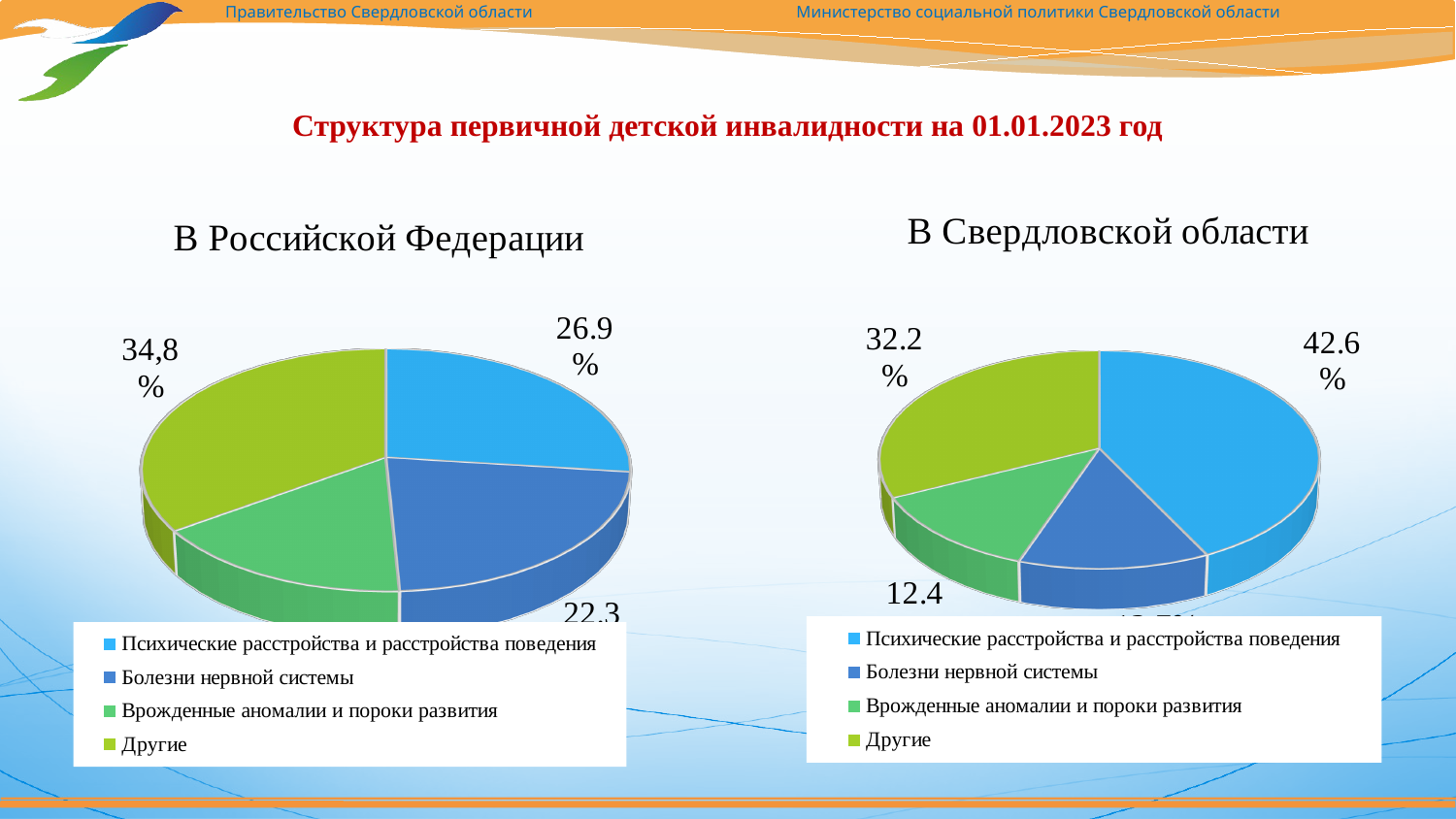
In the chart 'В Свердловской области', what share is shown for Психические расстройства и расстройства поведения? 42.6% In the chart 'В Свердловской области', which category has the largest slice? Психические расстройства и расстройства поведения What type of chart is used for 'В Российской Федерации'? Pie chart In the chart 'В Свердловской области', what value is shown for Врожденные аномалии и пороки развития? 12.4 By how many percentage points does the share of Психические расстройства и расстройства поведения in the 'В Свердловской области' chart exceed that in the 'В Российской Федерации' chart? 15.7 In the chart 'В Российской Федерации', which category has the largest slice? Другие How many categories does the legend of the 'В Свердловской области' chart list? 4 In the chart 'В Свердловской области', what share is shown for Другие? 32.2% In the chart 'В Российской Федерации', what value is shown for Болезни нервной системы? 22.3 In the chart 'В Российской Федерации', what share is shown for Психические расстройства и расстройства поведения? 26.9% In the chart 'В Российской Федерации', which is larger: Психические расстройства и расстройства поведения or Болезни нервной системы? Психические расстройства и расстройства поведения In the chart 'В Российской Федерации', what share is shown for Другие? 34,8%